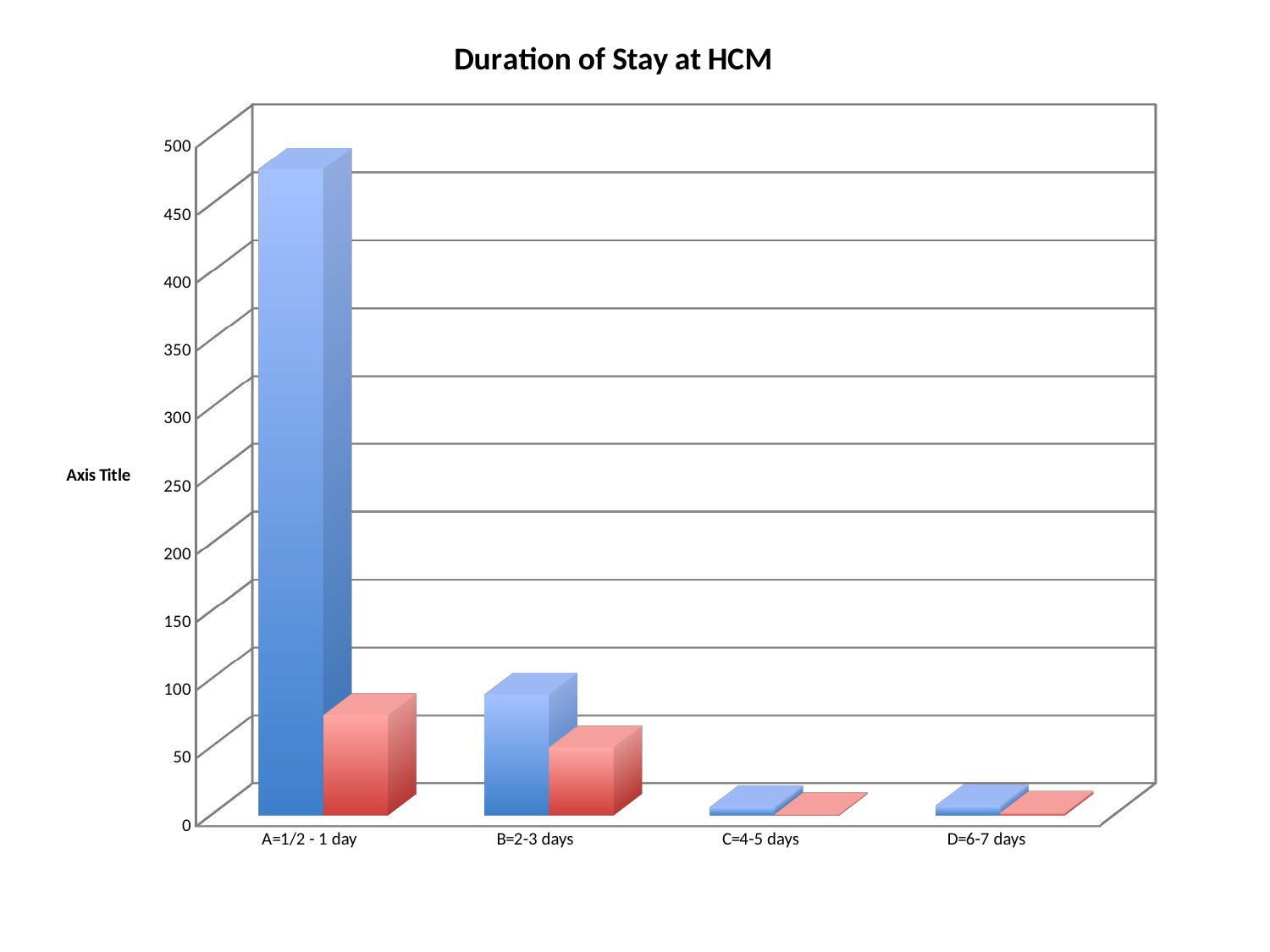
Is the value of the blue bar for C=4-5 days greater or less than 50? less What is the title of the chart? Duration of Stay at HCM Is the value of the blue bar for B=2-3 days greater or less than 150? less What label is shown on the vertical axis? Axis Title Do the blue bars rise or fall moving from A=1/2 - 1 day to D=6-7 days along the x axis? fall For A=1/2 - 1 day, which bar is taller, the blue one or the red one? the blue one Is the value of the red bar for A=1/2 - 1 day greater or less than 100? less Which is larger, the blue bar for A=1/2 - 1 day or the blue bar for B=2-3 days? A=1/2 - 1 day How many categories are shown on the x axis? 4 Which category has the tallest blue bar? A=1/2 - 1 day What kind of chart is shown on the slide? bar chart